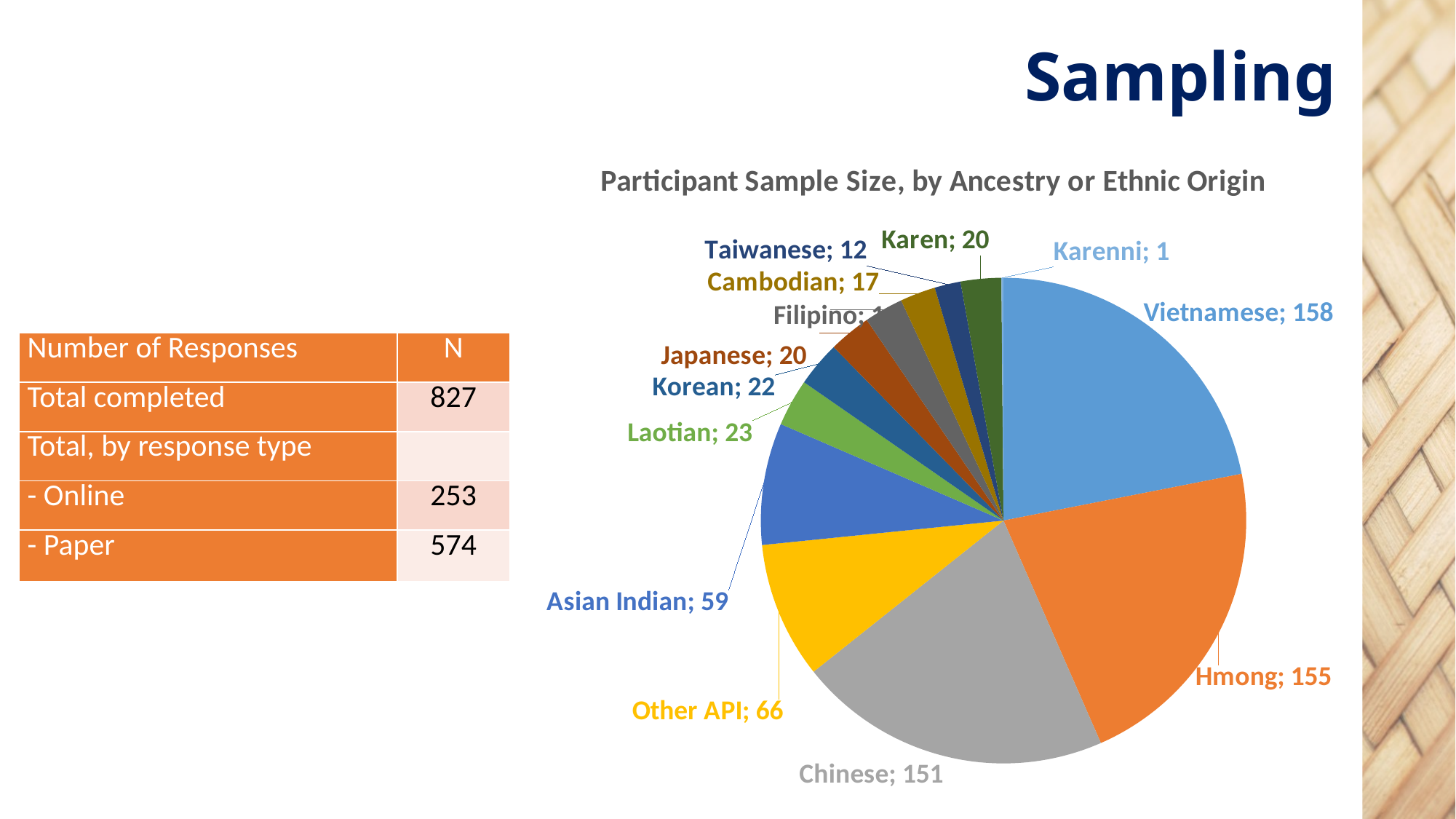
What is the sample size for Other API participants? 66 What is the sample size for Cambodian participants? 17 What is the sample size for Hmong participants? 155 What kind of chart is shown on the slide? pie chart Which ancestry group has the largest sample size? Vietnamese Which ancestry group has the smallest sample size? Karenni How many ancestry groups are shown in the pie chart? 13 What is the sample size for Vietnamese participants? 158 What is the difference between the Vietnamese and Hmong sample sizes? 3 What is the title of the chart? Participant Sample Size, by Ancestry or Ethnic Origin Which has a larger sample size, Laotian or Korean? Laotian What is the difference between the Other API and Asian Indian sample sizes? 7